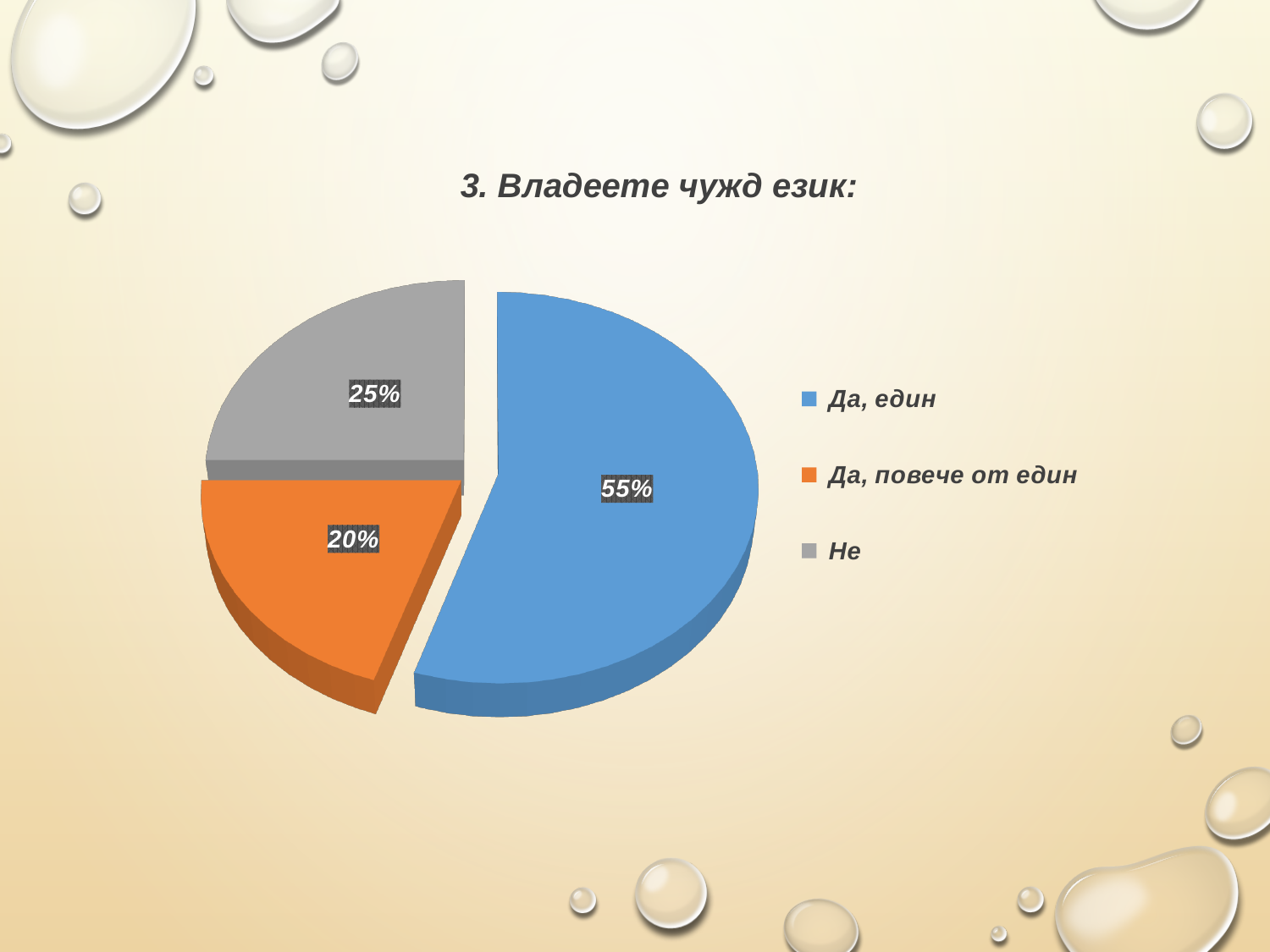
What is the difference between the shares of "Да, един" and "Не"? 30% Which category has the smallest slice? Да, повече от един How many slices does the pie chart have? 3 What is the difference between the shares of "Не" and "Да, повече от един"? 5% Which is larger, the share for "Не" or the share for "Да, повече от един"? Не Which category has the largest slice? Да, един What kind of chart is shown on the slide? pie chart What share of the pie does "Да, повече от един" take? 20% What share of the pie does "Да, един" take? 55% What is the title of the chart? 3. Владеете чужд език: What share of the pie does "Не" take? 25% Which colour represents "Не" in the legend? grey